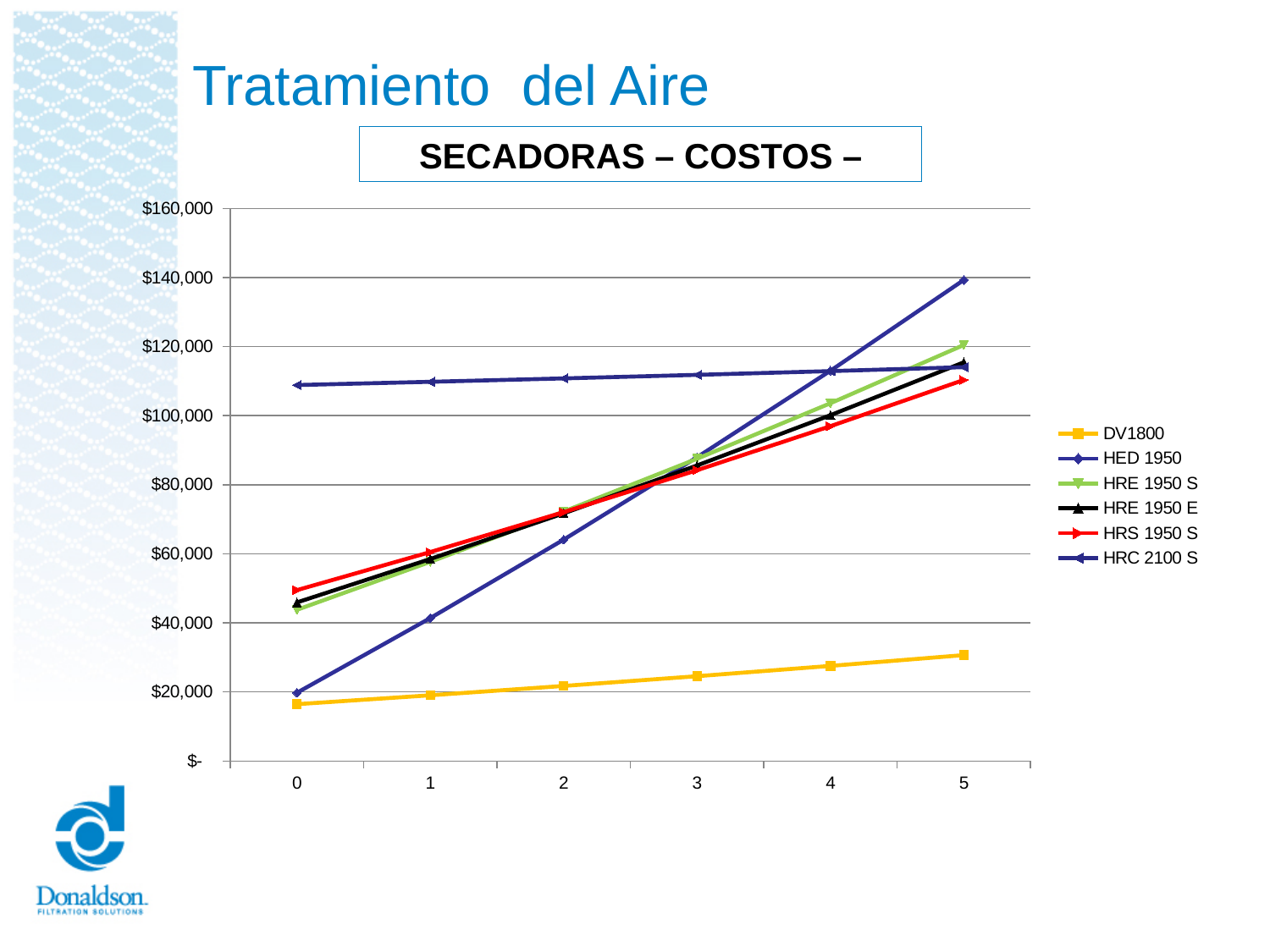
How many series does the legend list? 6 Is the value for HED 1950 at x = 5 greater or less than $120,000? greater Is the value for HRC 2100 S at x = 0 greater or less than $100,000? greater Which series has the highest value at x = 5? HED 1950 Do the values for DV1800 rise or fall from x = 0 to x = 5? rise Is the value for DV1800 at x = 5 greater or less than $40,000? less Which series has the highest value at x = 0? HRC 2100 S Which series has the lowest value at x = 0? DV1800 What kind of chart is shown on the slide? line chart Which series has the lowest value at x = 5? DV1800 At x = 1, which is larger: HED 1950 or HRS 1950 S? HRS 1950 S How many points are plotted along the x axis for each series? 6